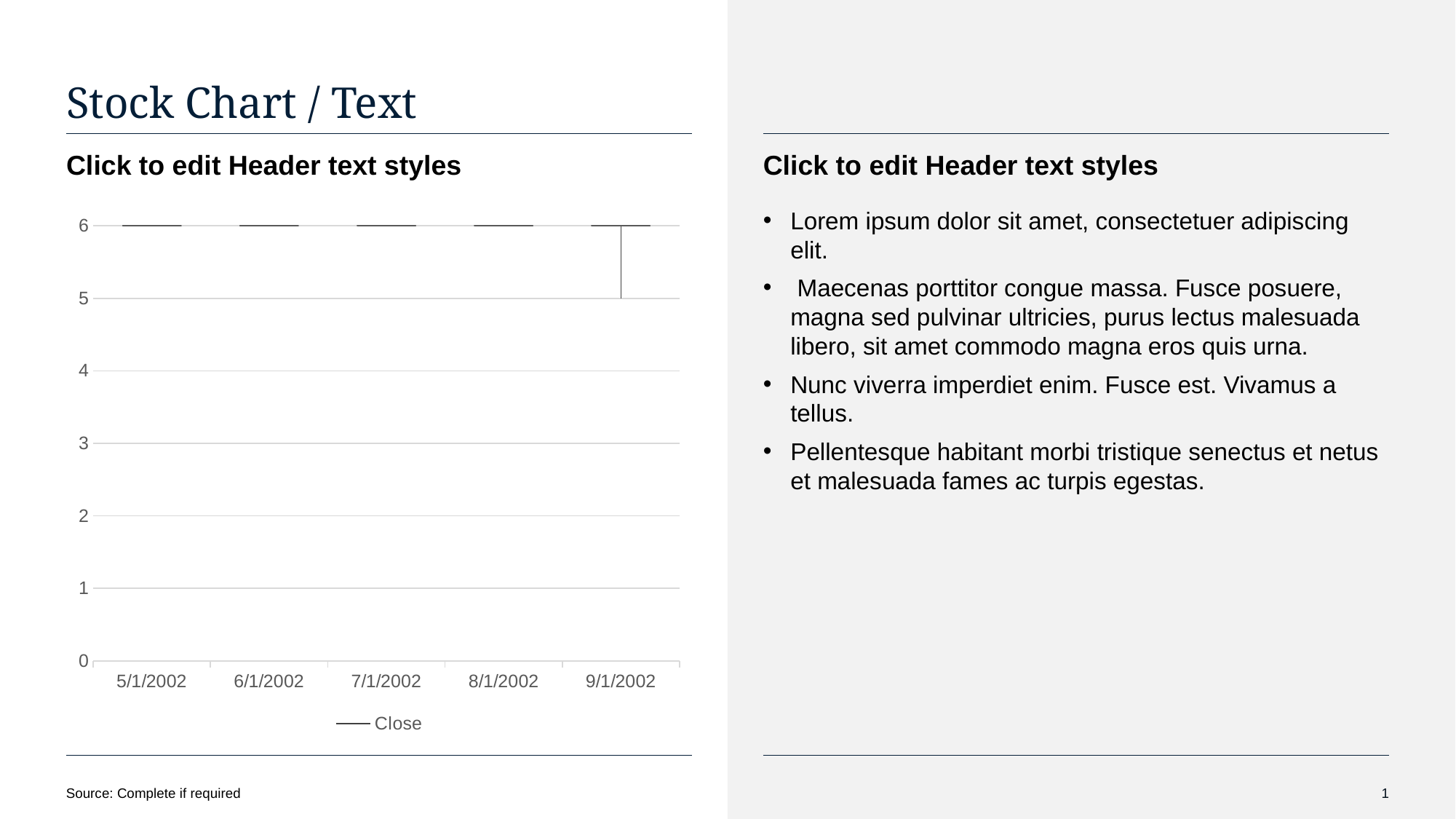
How many dates are shown on the x axis of the chart? 5 What is the Close value for 5/1/2002? 6 What is the first date shown on the x axis of the chart? 5/1/2002 What series name is shown in the chart legend? Close How many series does the chart legend list? 1 What is the Close value for 7/1/2002? 6 What kind of chart is shown on the slide? stock chart What is the Close value for 9/1/2002? 6 What is the highest value shown on the chart's y axis? 6 Is the Close value for 8/1/2002 greater or less than 4? greater Is the Close value for 6/1/2002 greater or less than 3? greater Do the Close values rise, fall or stay flat from 5/1/2002 to 9/1/2002? stay flat